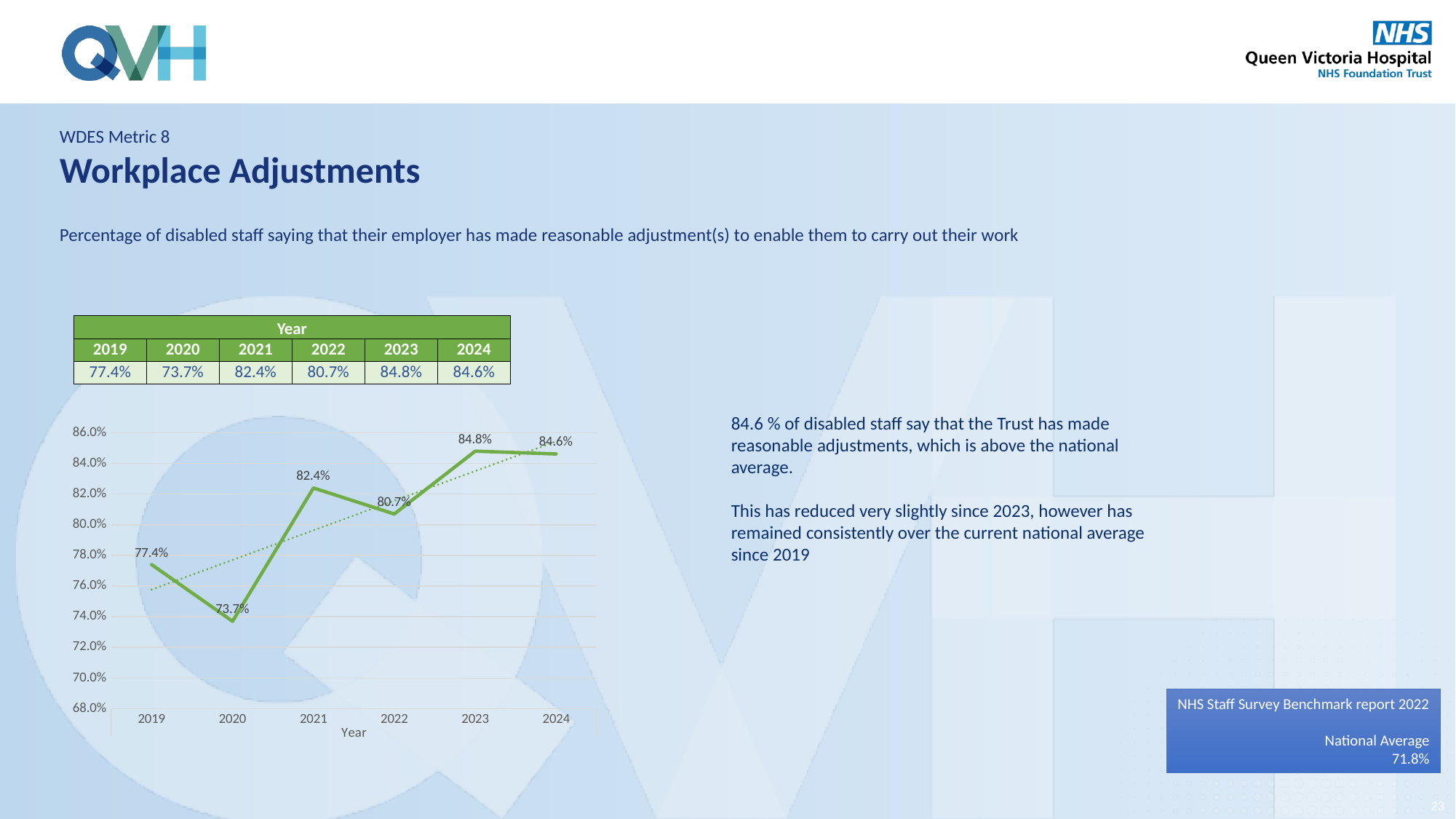
What kind of chart is shown? line chart Which year has the highest value? 2023 What is the value for 2022? 80.7% Which is larger, the value for 2021 or the value for 2022? 2021 What is the value for 2024? 84.6% What is the difference between the values for 2023 and 2024? 0.2% What is the value for 2019? 77.4% What is the difference between the values for 2021 and 2020? 8.7% What is the label of the x axis? Year Which year has the lowest value? 2020 What is the value for 2020? 73.7% How many years are plotted on the chart? 6